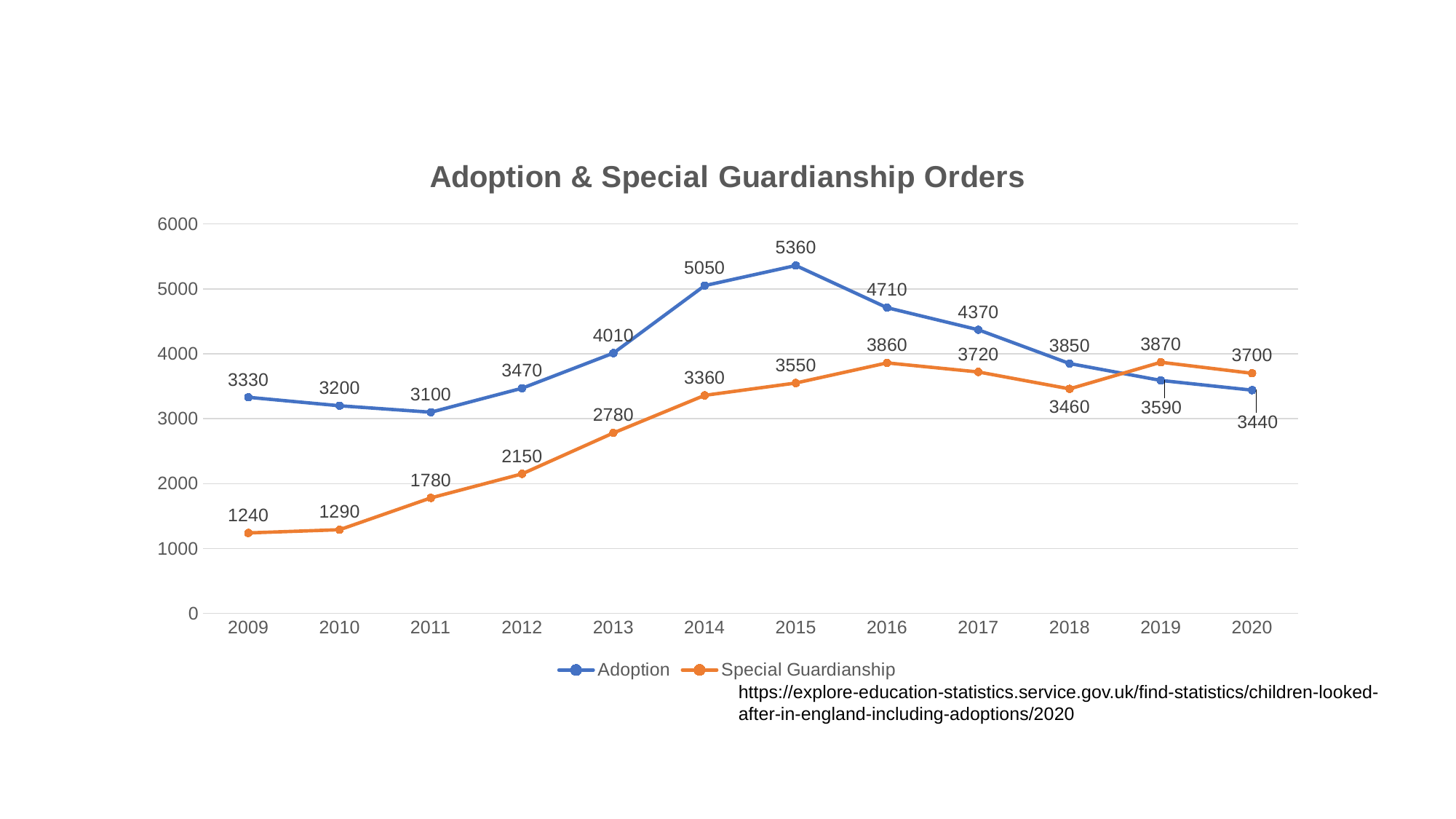
What is the Special Guardianship value for 2009? 1240 Which series has the larger value in 2019, Adoption or Special Guardianship? Special Guardianship What is the Adoption value for 2020? 3440 What is the Adoption value for 2015? 5360 Is the Special Guardianship value for 2013 greater or less than 3000? less In which year is the Adoption series highest? 2015 How many series does the legend list? 2 How many years are shown on the x axis? 12 What is the difference between the Adoption and Special Guardianship values in 2014? 1690 In which year is the Special Guardianship series lowest? 2009 Does the Special Guardianship series rise or fall from 2009 to 2016? rise What kind of chart is shown? line chart